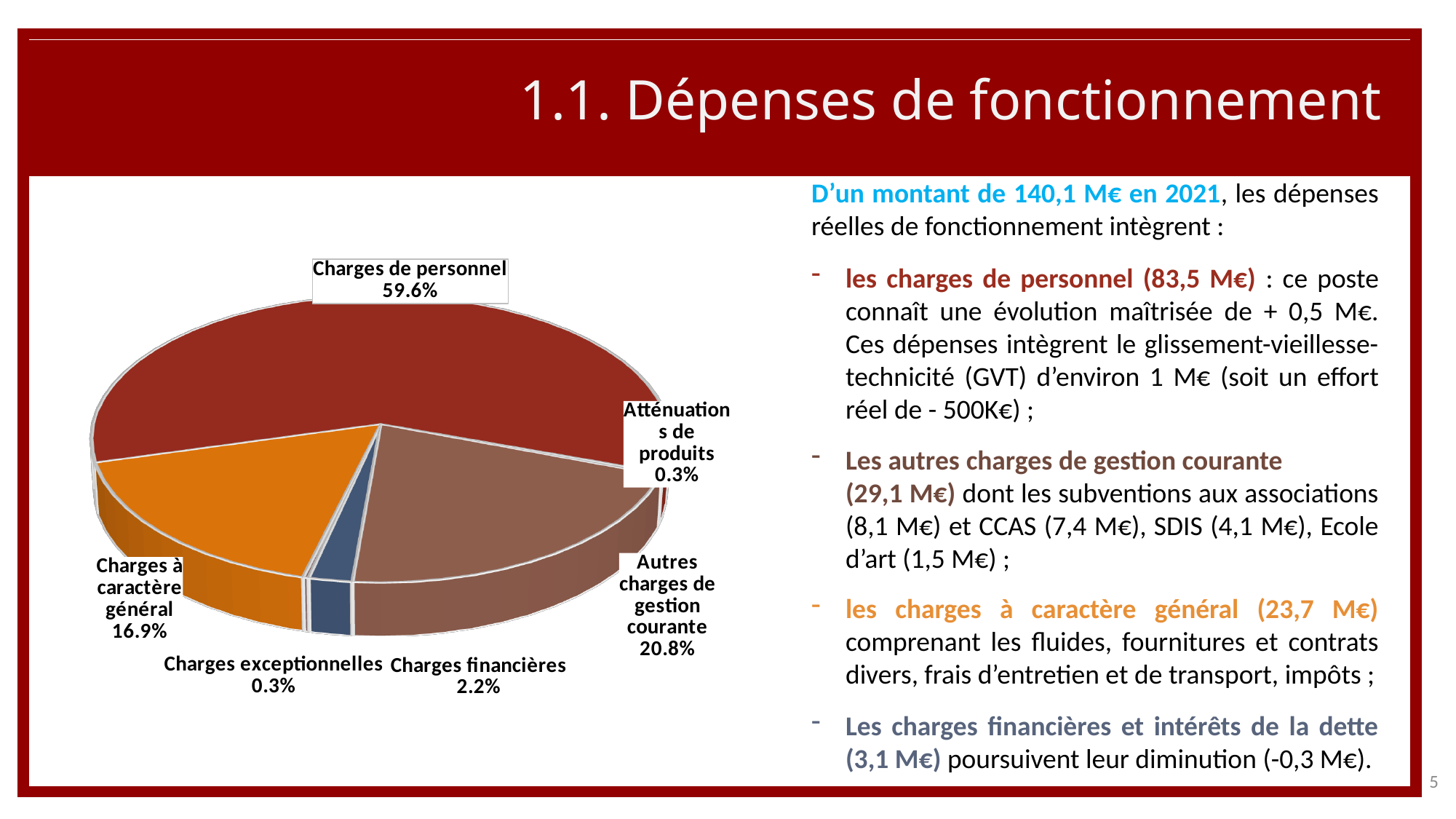
Which is larger: Charges à caractère général or Autres charges de gestion courante? Autres charges de gestion courante What kind of chart is shown on the slide? Pie chart How many slices does the pie chart have? 6 What percentage is shown for Charges exceptionnelles? 0.3% What percentage is shown for Charges à caractère général? 16.9% What is the difference in percentage points between Charges de personnel and Autres charges de gestion courante? 38.8 What colour is the Charges de personnel slice? Dark red What is the value shown for Autres charges de gestion courante? 20.8% What is the value shown for Atténuations de produits? 0.3% What is the value shown for Charges financières? 2.2% What share of the pie does Charges de personnel represent? 59.6% Which category has the largest slice of the pie? Charges de personnel